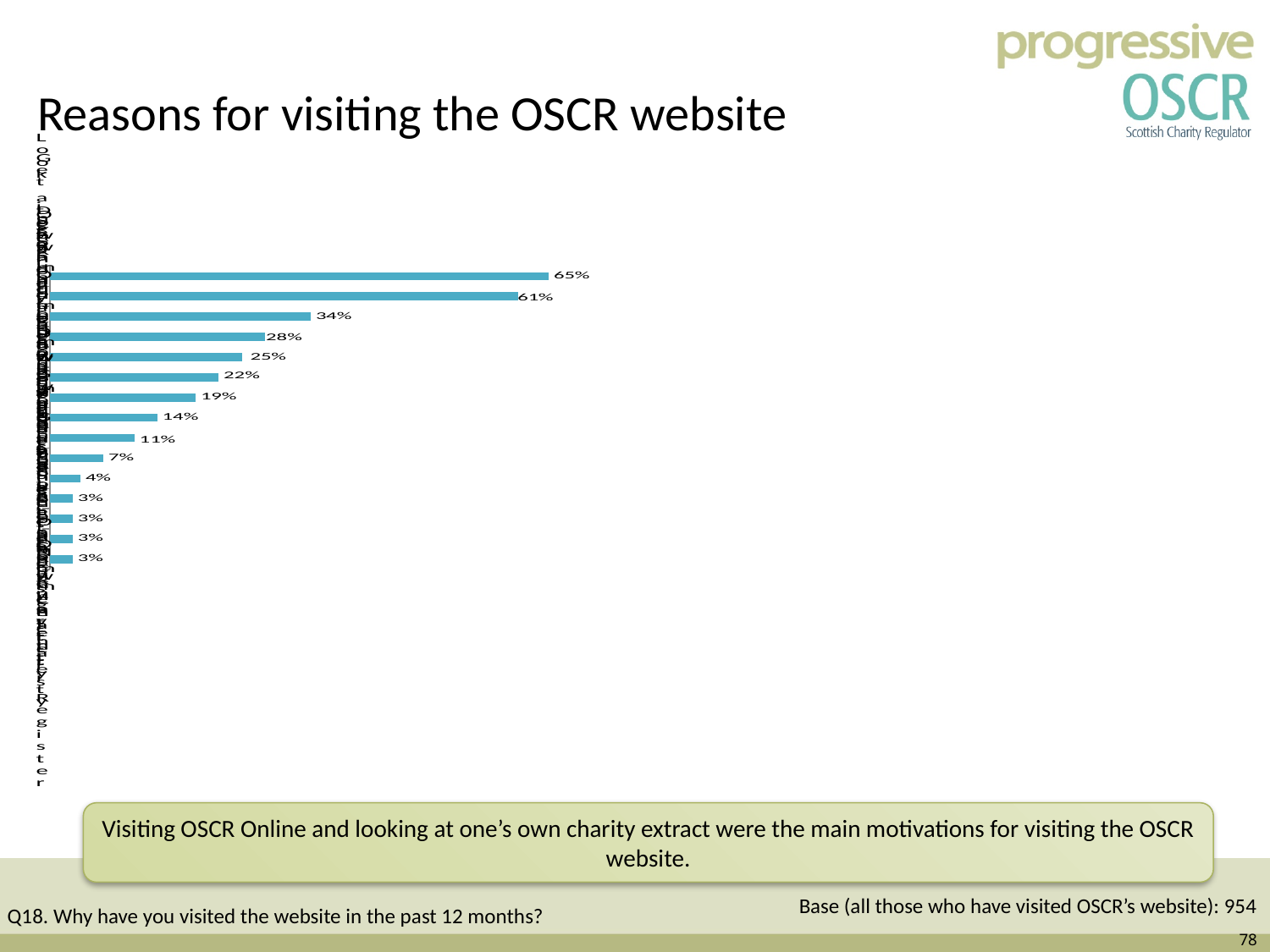
What is the title of the chart on the slide? Reasons for visiting the OSCR website How many bars are plotted in the chart? 15 What kind of chart is shown on the slide? bar chart What is the difference between the top two bars (65% and 61%)? 4 percentage points How many bars in the chart are labelled 3%? 4 What is the highest value shown in the chart? 65% What value is labelled on the third bar from the top? 34% Which is larger, the second bar from the top or the third bar from the top? the second bar (61%) What value is labelled on the topmost bar of the chart? 65% What value is labelled on the second bar from the top? 61% Do the bar values increase or decrease going from the top of the chart to the bottom? decrease What is the lowest value shown in the chart? 3%